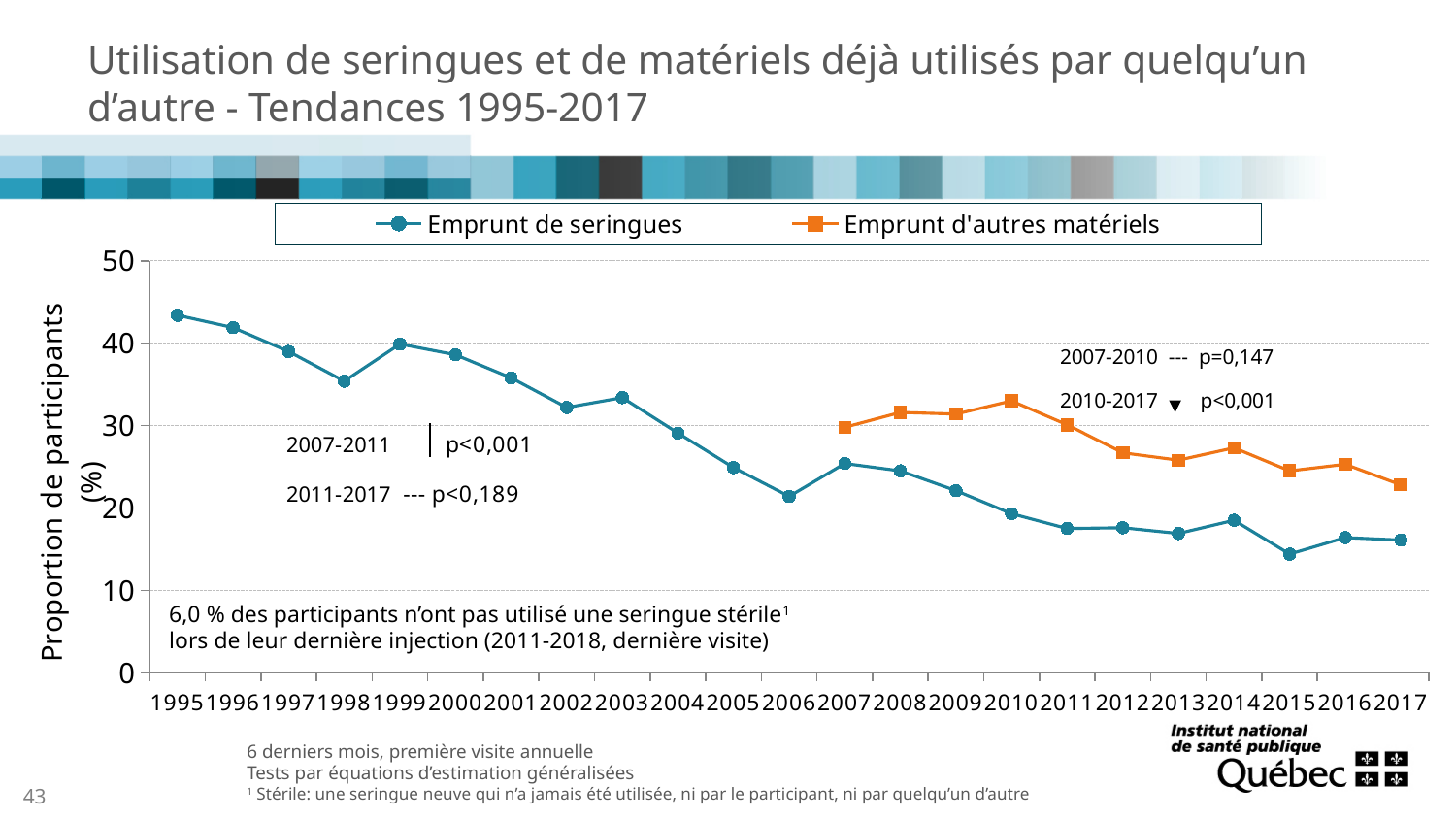
In 2010, which series has the larger value, Emprunt de seringues or Emprunt d'autres matériels? Emprunt d'autres matériels Is the value for Emprunt de seringues in 1995 greater or less than 40? greater How many years are shown on the x axis? 23 Is the value for Emprunt d'autres matériels in 2017 greater or less than 30? less Does Emprunt de seringues generally rise or fall from 1995 to 2017? fall In which year is Emprunt de seringues at its lowest? 2015 Is the value for Emprunt de seringues in 2015 greater or less than 20? less In which year is Emprunt de seringues at its highest? 1995 How many series does the legend list? 2 What kind of chart is shown on the slide? Line chart Which series is shown with orange square markers? Emprunt d'autres matériels